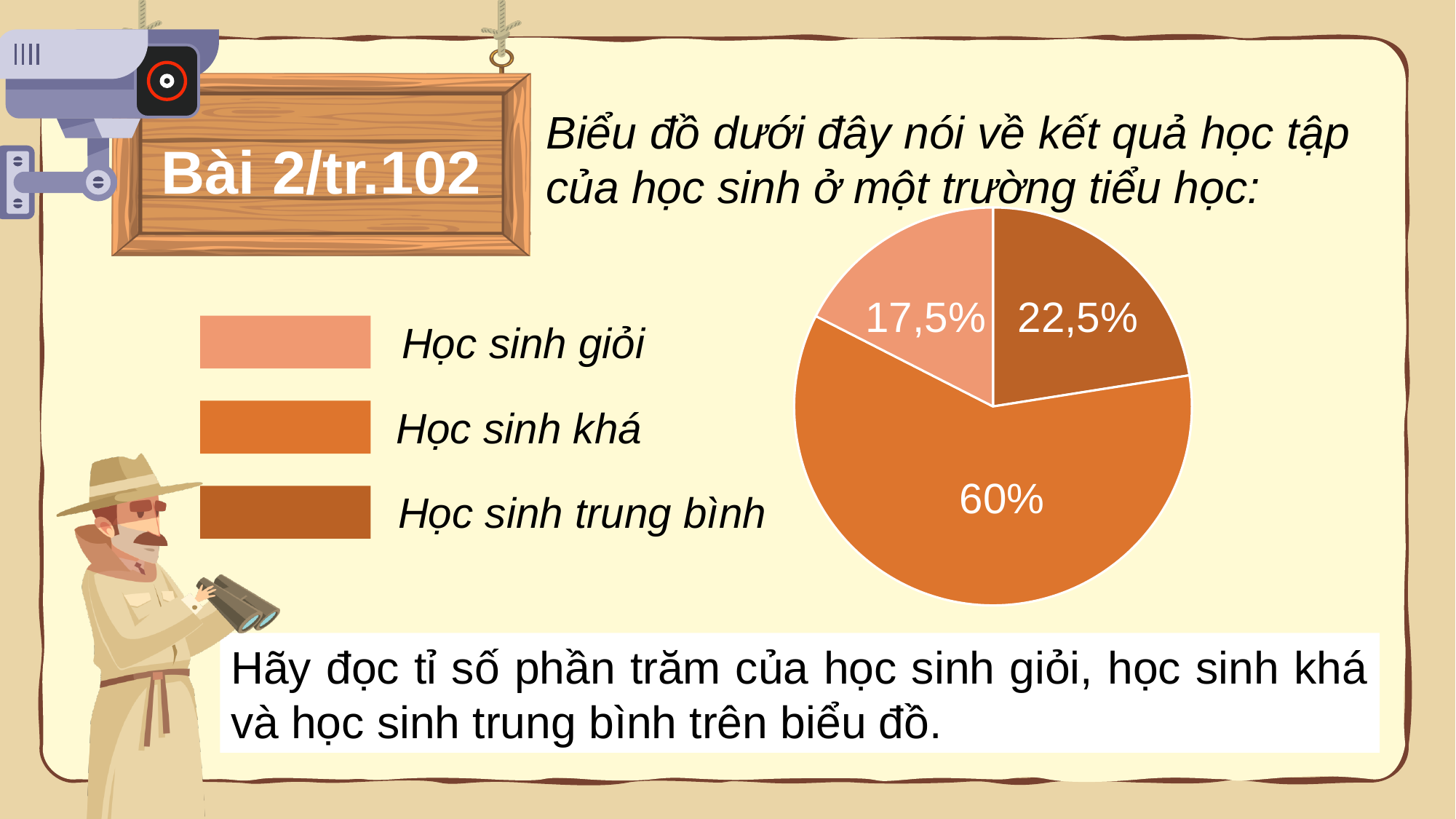
How many slices does the pie chart have? 3 Which category has the largest slice of the pie chart? Học sinh khá What is the difference in percentage points between Học sinh khá and Học sinh trung bình? 37,5 Which category is shown in the darkest brown colour in the legend? Học sinh trung bình What kind of chart is shown on the slide? Pie chart What percentage of the pie chart is labelled for Học sinh khá? 60% What percentage of the pie chart is labelled for Học sinh trung bình? 22,5% What percentage of the pie chart is labelled for Học sinh giỏi? 17,5% What is the combined share of Học sinh giỏi and Học sinh trung bình? 40% Which is larger: the slice for Học sinh trung bình or the slice for Học sinh giỏi? Học sinh trung bình What is the difference in percentage points between Học sinh trung bình and Học sinh giỏi? 5 Which category has the smallest slice of the pie chart? Học sinh giỏi